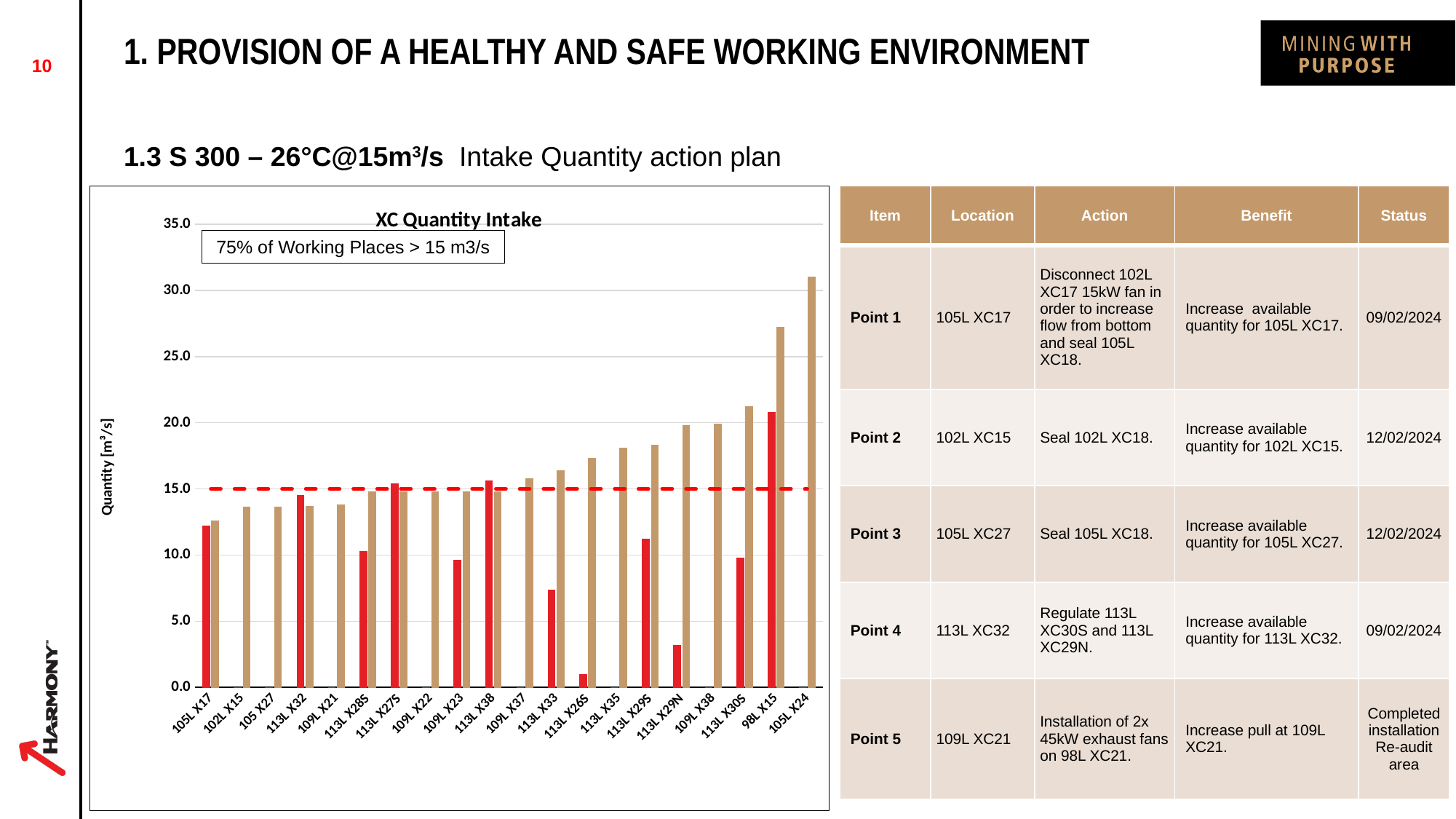
What is the label on the vertical axis of the XC Quantity Intake chart? Quantity [m³/s] Is the tan bar for 105L X24 greater or less than 30.0? greater What kind of chart is the XC Quantity Intake chart? bar chart Which category has the shortest tan bar in the XC Quantity Intake chart? 105L X17 Which has the taller red bar, 98L X15 or 113L X29S? 98L X15 Which category has the tallest tan bar in the XC Quantity Intake chart? 105L X24 How many categories are shown on the x axis of the XC Quantity Intake chart? 20 Is the tan bar for 105L X17 greater or less than 15.0? less Which category has the tallest red bar in the XC Quantity Intake chart? 98L X15 Do the tan bars rise or fall from left to right along the x axis of the XC Quantity Intake chart? rise What is the title of the chart on the slide? XC Quantity Intake Is the red bar for 113L X29N greater or less than 5.0? less